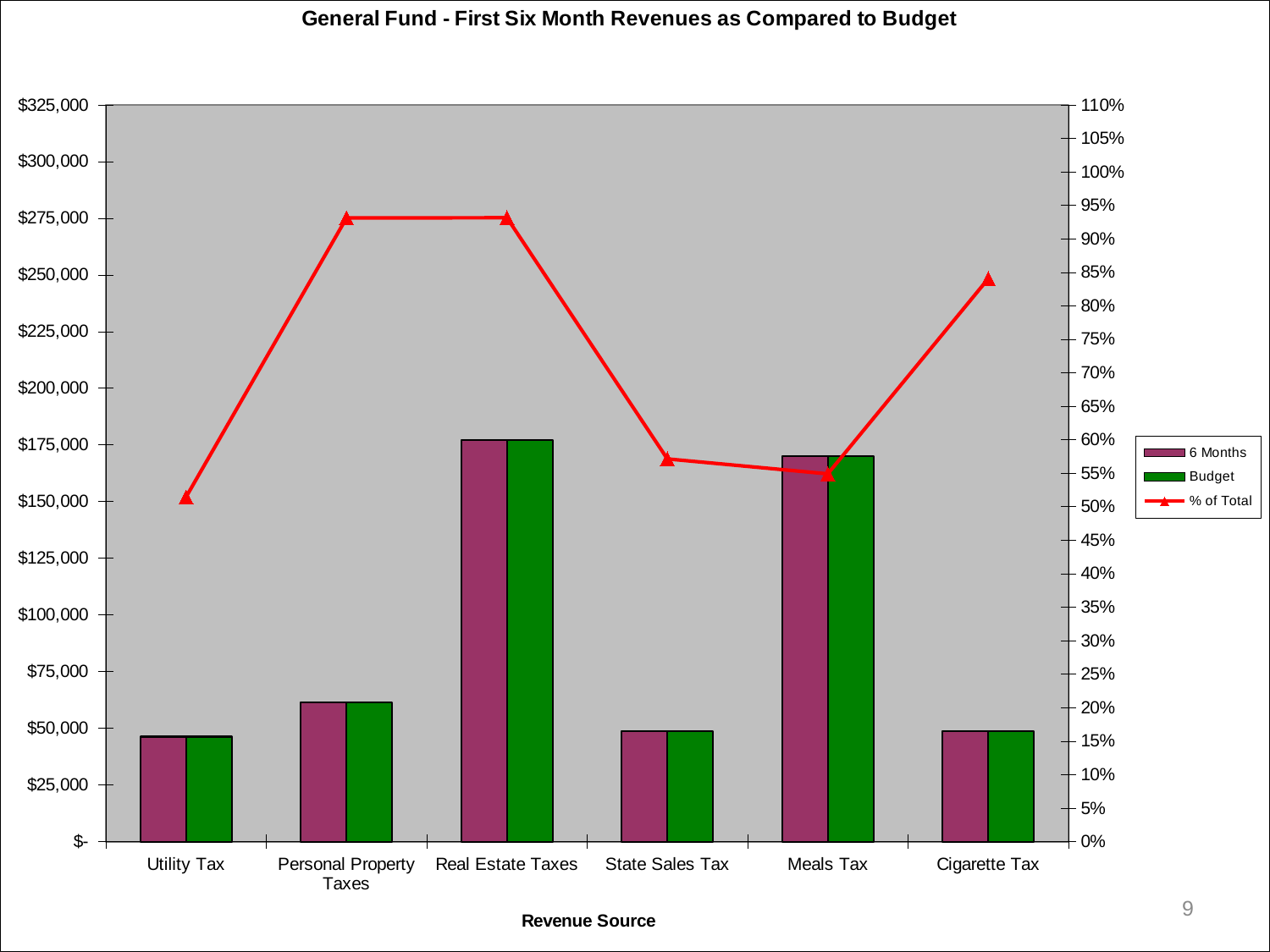
Does the % of Total line rise or fall from Real Estate Taxes to State Sales Tax? fall Which revenue source has the highest 6 Months bar? Real Estate Taxes Which is larger, the 6 Months value for Real Estate Taxes or for Utility Tax? Real Estate Taxes Is the % of Total value for Cigarette Tax greater or less than 80%? greater How many series does the legend list? 3 Is the % of Total value for Personal Property Taxes greater or less than 90%? greater What kind of chart is this? Combined bar and line chart How many revenue source categories are shown on the x axis? 6 Is the 6 Months value for Utility Tax greater or less than $50,000? less What is the title of the chart? General Fund - First Six Month Revenues as Compared to Budget